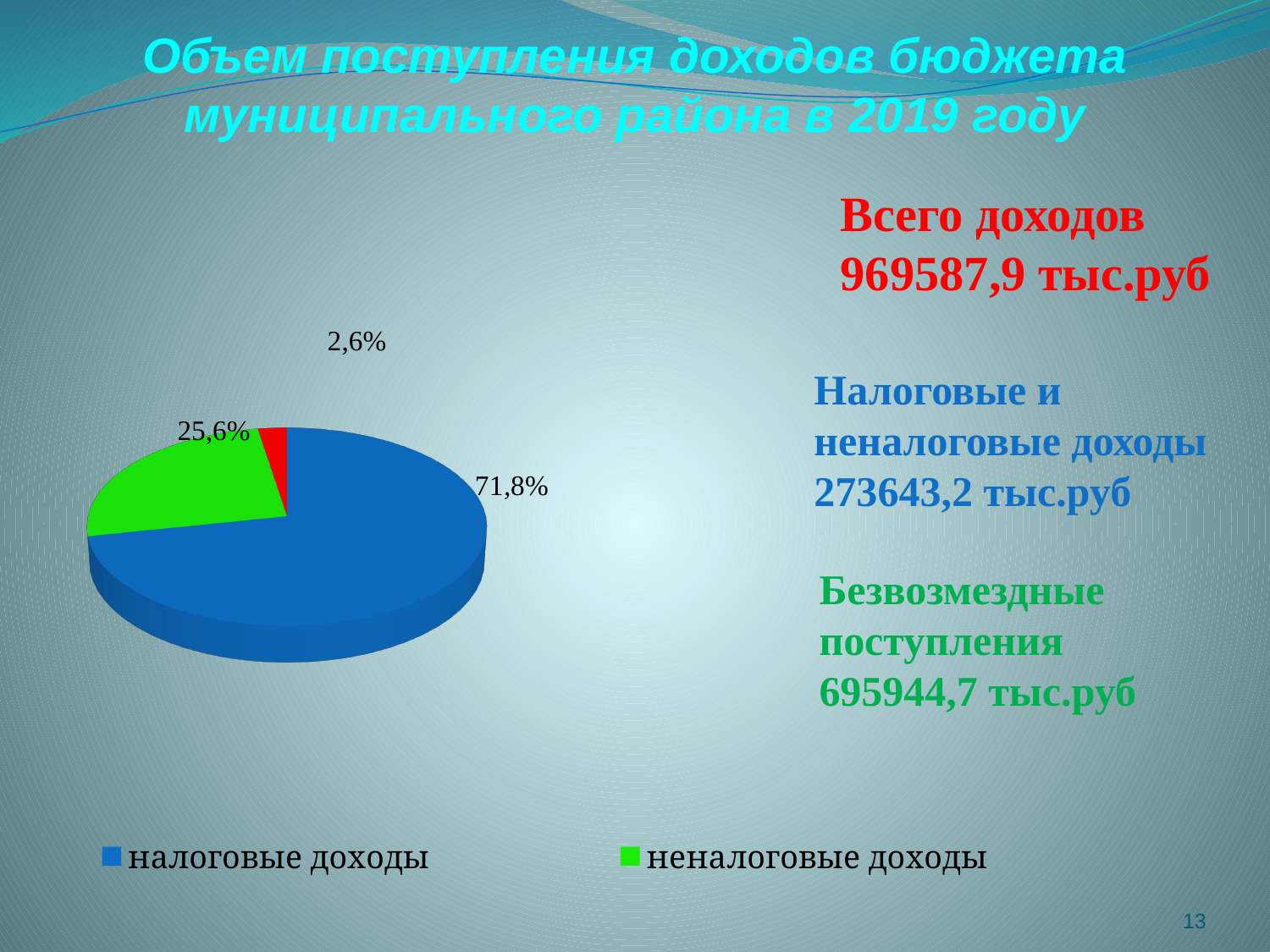
What is the smallest percentage labelled on the pie? 2,6% What percentage is labelled on the red slice of the pie? 2,6% By how many percentage points does the налоговые доходы slice exceed the неналоговые доходы slice? 46,2 Which legend category has the largest slice of the pie? налоговые доходы How many entries does the legend list? 2 What percentage of the pie is labelled for неналоговые доходы? 25,6% How many slices does the pie chart have? 3 What kind of chart is shown on the slide? pie chart What colour is the slice for неналоговые доходы? green What colour is the slice for налоговые доходы? blue What percentage of the pie is labelled for налоговые доходы? 71,8% Which slice is larger: налоговые доходы or неналоговые доходы? налоговые доходы